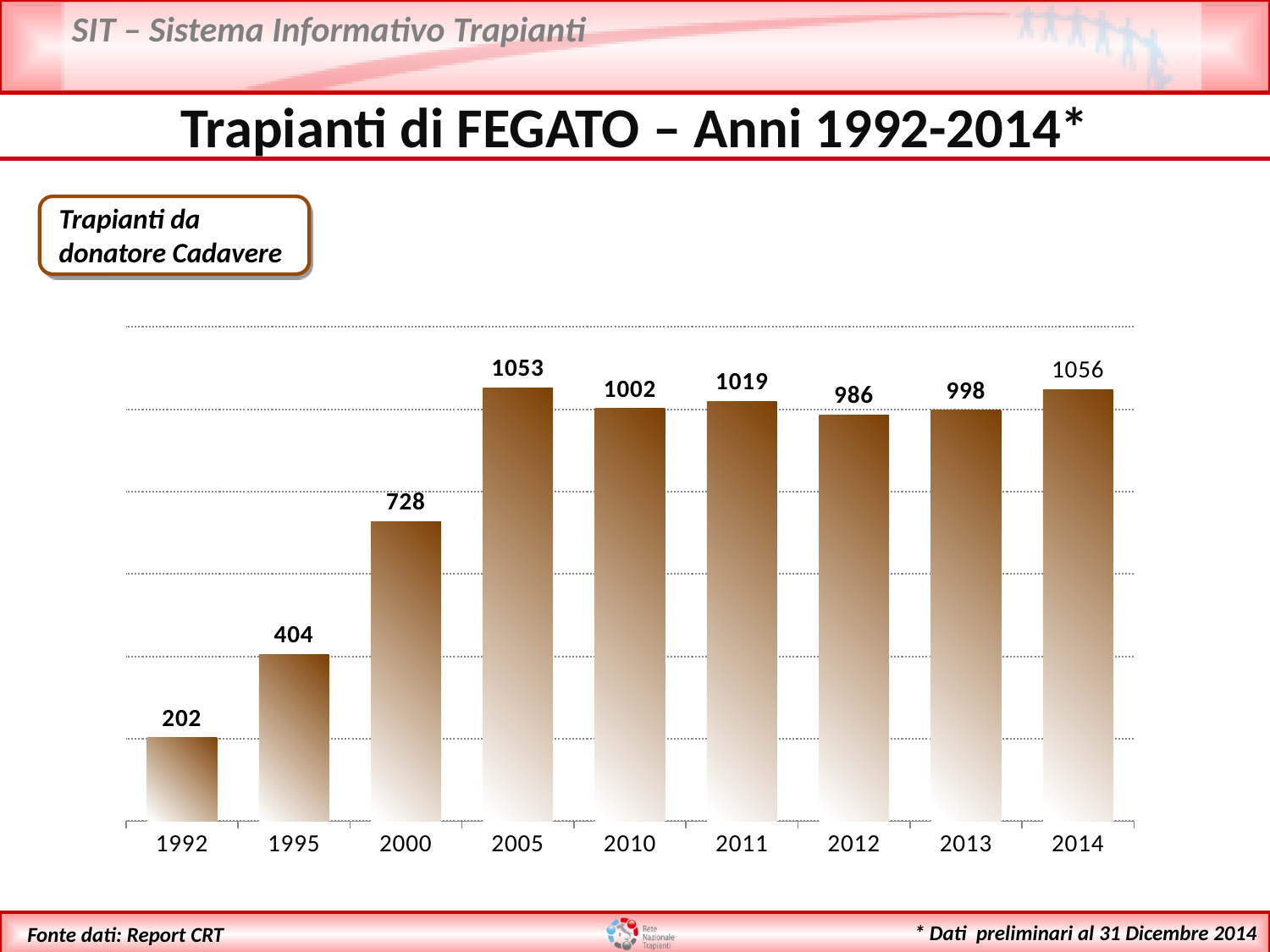
What is the value for 1992? 202 What kind of chart is shown on the slide? bar chart Which is larger, the value for 2011 or the value for 2010? 2011 What is the difference between the values for 2014 and 2013? 58 Which year has the highest value? 2014 How many years are shown on the x axis? 9 What is the value for 2012? 986 What is the title of the slide's chart? Trapianti di FEGATO – Anni 1992-2014* Which year has the lowest value? 1992 What is the difference between the values for 2000 and 1995? 324 Do the values rise or fall from 1992 to 2005? rise What is the value for 2005? 1053